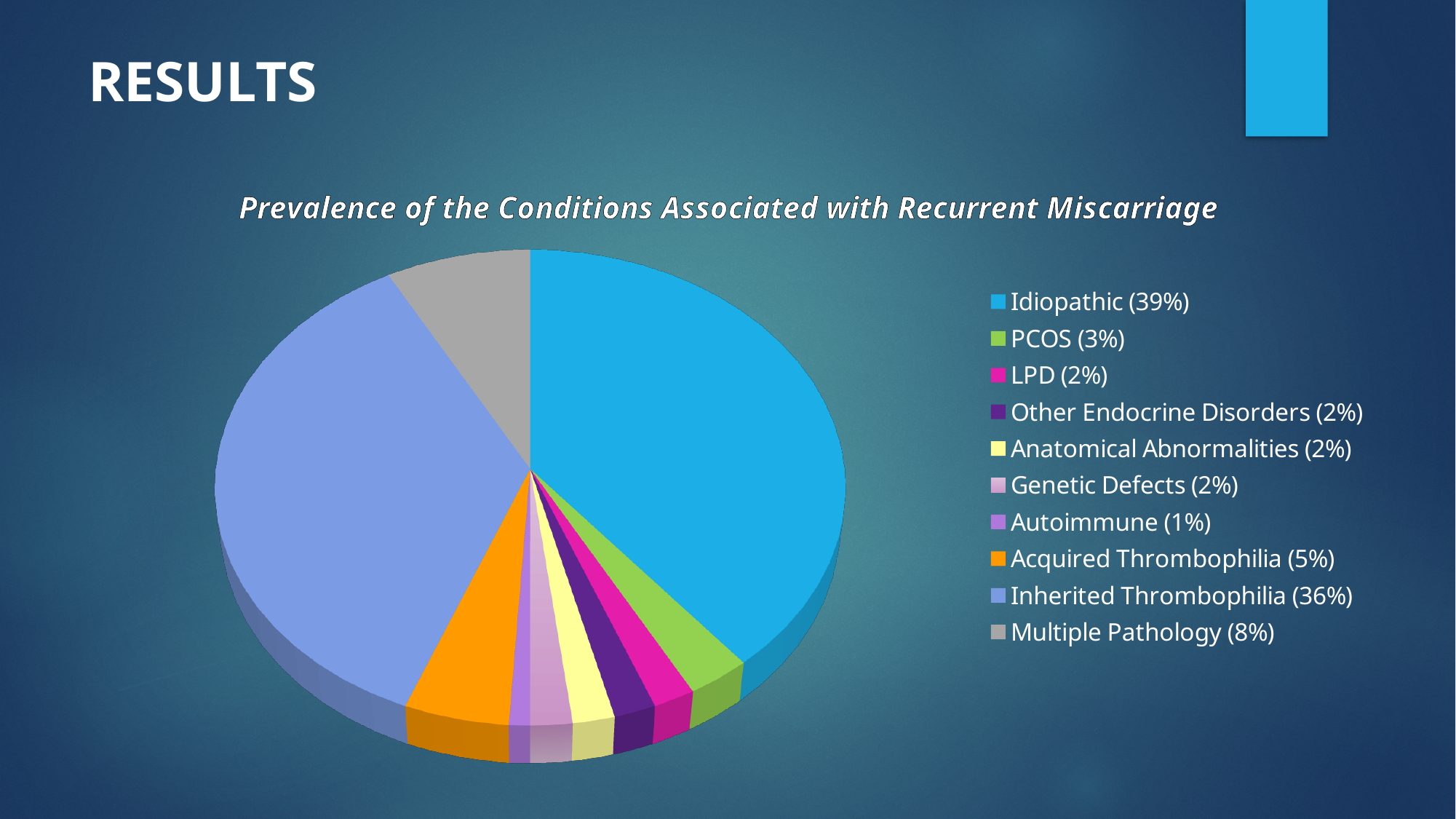
Which category has the smallest share of the pie? Autoimmune What share of the pie is Idiopathic? 39% What is the difference between the Idiopathic and Inherited Thrombophilia shares? 3% What is the value for Multiple Pathology? 8% What kind of chart is shown on the slide? Pie chart What share of the pie is Inherited Thrombophilia? 36% What is the value for Acquired Thrombophilia? 5% What colour is the Idiopathic slice? Blue Which category has the largest share of the pie? Idiopathic What is the title of the chart? Prevalence of the Conditions Associated with Recurrent Miscarriage How many categories does the pie chart show? 10 Which is larger, the share for PCOS or the share for Acquired Thrombophilia? Acquired Thrombophilia